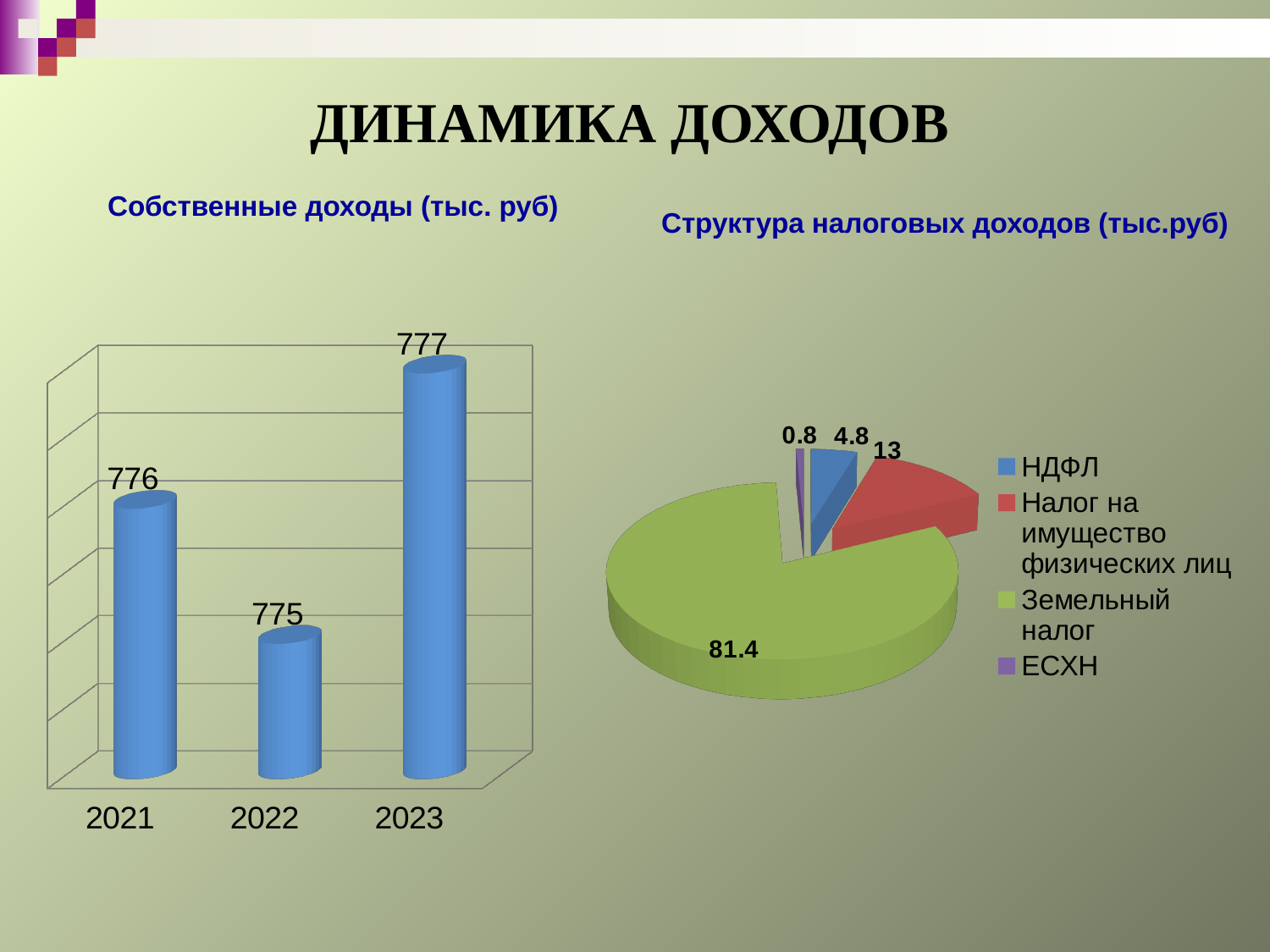
In the pie chart 'Структура налоговых доходов (тыс.руб)', what is the value for НДФЛ? 4.8 How many categories does the legend of the pie chart 'Структура налоговых доходов (тыс.руб)' list? 4 What kind of chart is the left chart 'Собственные доходы (тыс. руб)'? Bar chart In the pie chart 'Структура налоговых доходов (тыс.руб)', what is the value for Земельный налог? 81.4 In the bar chart 'Собственные доходы (тыс. руб)', what is the value for 2022? 775 In the bar chart 'Собственные доходы (тыс. руб)', which year has the lowest value? 2022 In the bar chart 'Собственные доходы (тыс. руб)', which year has the highest value? 2023 In the bar chart 'Собственные доходы (тыс. руб)', how many years are shown? 3 In the bar chart 'Собственные доходы (тыс. руб)', what is the value for 2021? 776 In the pie chart 'Структура налоговых доходов (тыс.руб)', which category has the smallest slice? ЕСХН In the pie chart 'Структура налоговых доходов (тыс.руб)', which is larger: Налог на имущество физических лиц or НДФЛ? Налог на имущество физических лиц In the bar chart 'Собственные доходы (тыс. руб)', what is the difference between the values for 2023 and 2022? 2